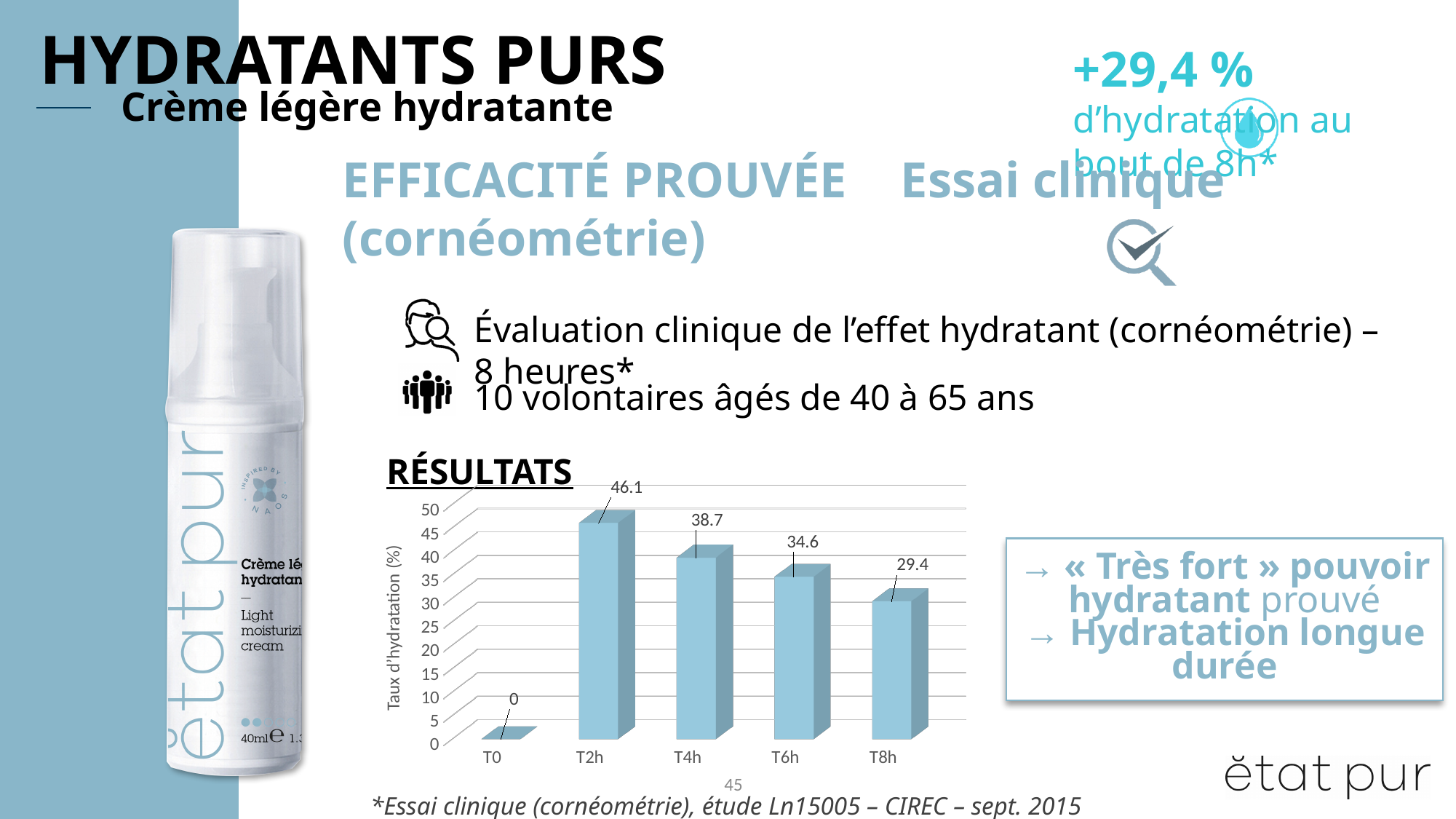
Which time point has the highest hydration rate? T2h Which time point has the lowest hydration rate? T0 What is the hydration rate at T4h? 38.7 From T2h to T8h, do the hydration rate values rise or fall? Fall What is the difference between the hydration rate at T2h and at T8h? 16.7 What is the hydration rate (Taux d'hydratation) at T2h? 46.1 What kind of chart is shown under RÉSULTATS? Bar chart What is the hydration rate at T0? 0 What is the hydration rate at T8h? 29.4 Is the value for T6h greater or less than 30? greater Which has a higher hydration rate, T4h or T6h? T4h How many time points are shown on the x axis of the chart? 5